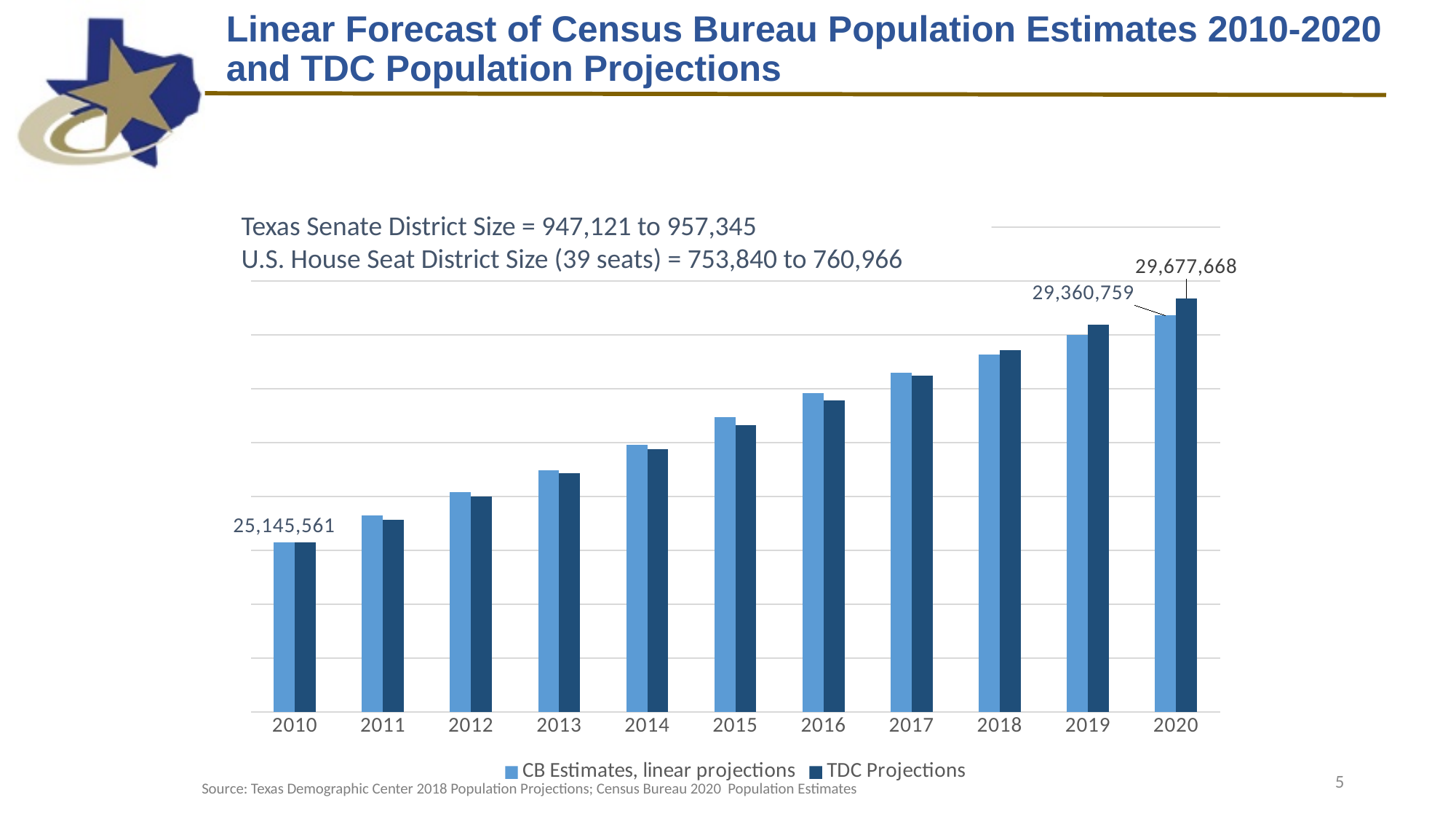
In 2015, which series has the larger value: CB Estimates, linear projections or TDC Projections? CB Estimates, linear projections What is the difference between the TDC Projections value and the CB Estimates value in 2020? 316,909 In 2020, which series has the larger value: CB Estimates, linear projections or TDC Projections? TDC Projections How many years are shown along the x axis of the chart? 11 What value is labelled on the chart for 2010? 25,145,561 Which year has the highest TDC Projections value? 2020 What is the labelled value for CB Estimates, linear projections in 2020? 29,360,759 What kind of chart is shown on the slide? bar chart What is the labelled value for TDC Projections in 2020? 29,677,668 How many series does the chart's legend list? 2 Do the values rise or fall from 2010 to 2020? rise Which year has the lowest CB Estimates, linear projections value? 2010